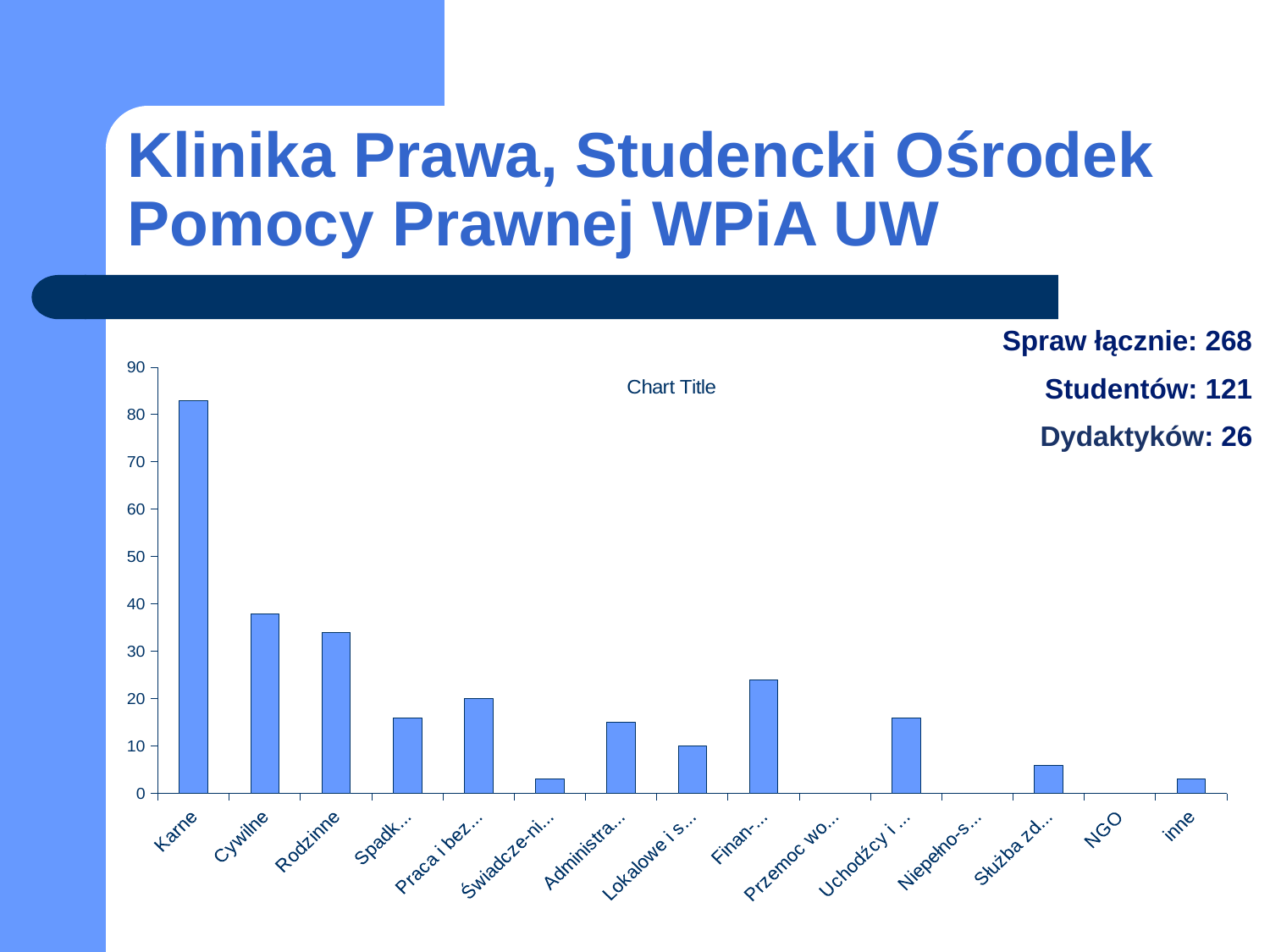
What kind of chart is shown on the slide? bar chart Is the value for Cywilne greater or less than 40? less Which is larger, the value for Praca i bez... or the value for Świadcze-ni...? Praca i bez... Which category has the highest value in the chart? Karne Is the value for Rodzinne greater or less than 30? greater Is the value for Finan-... greater or less than 20? greater What is the title shown on the chart? Chart Title Which is larger, the value for Finan-... or the value for Lokalowe i s...? Finan-... How many categories are shown on the x axis of the chart? 15 Which is larger, the value for Karne or the value for Cywilne? Karne